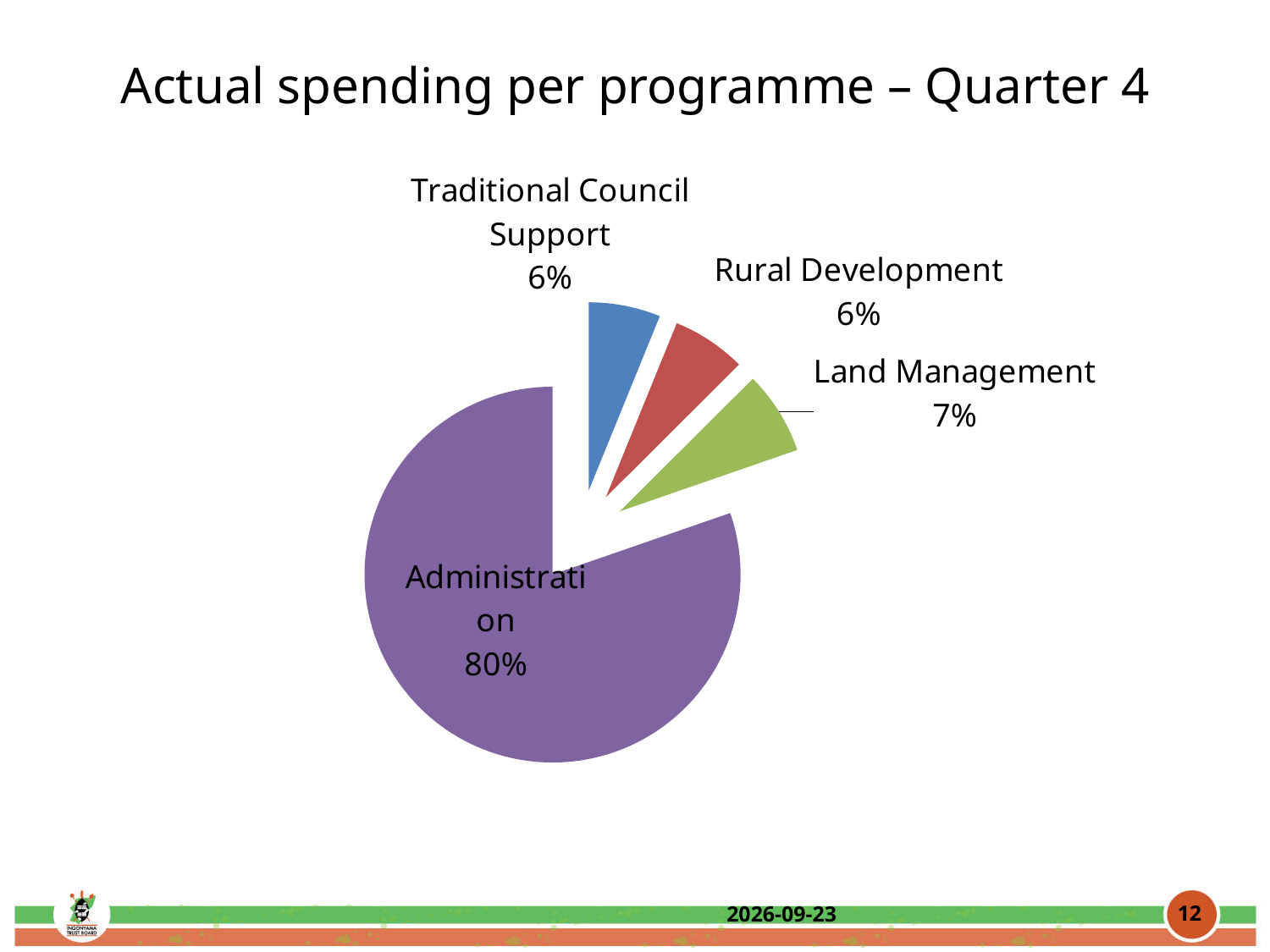
Which programme has the largest share of spending? Administration What is the combined share of Rural Development and Traditional Council Support? 12% What percentage is shown for Rural Development? 6% What type of chart is shown on the slide? pie chart What percentage is shown for Traditional Council Support? 6% What share of actual spending does Administration account for? 80% What is the title of the chart? Actual spending per programme – Quarter 4 What is the difference in percentage points between Administration and Land Management? 73 What colour is the Administration slice? purple How many slices does the pie chart have? 4 What percentage is shown for Land Management? 7% Which is larger, the share for Land Management or the share for Rural Development? Land Management